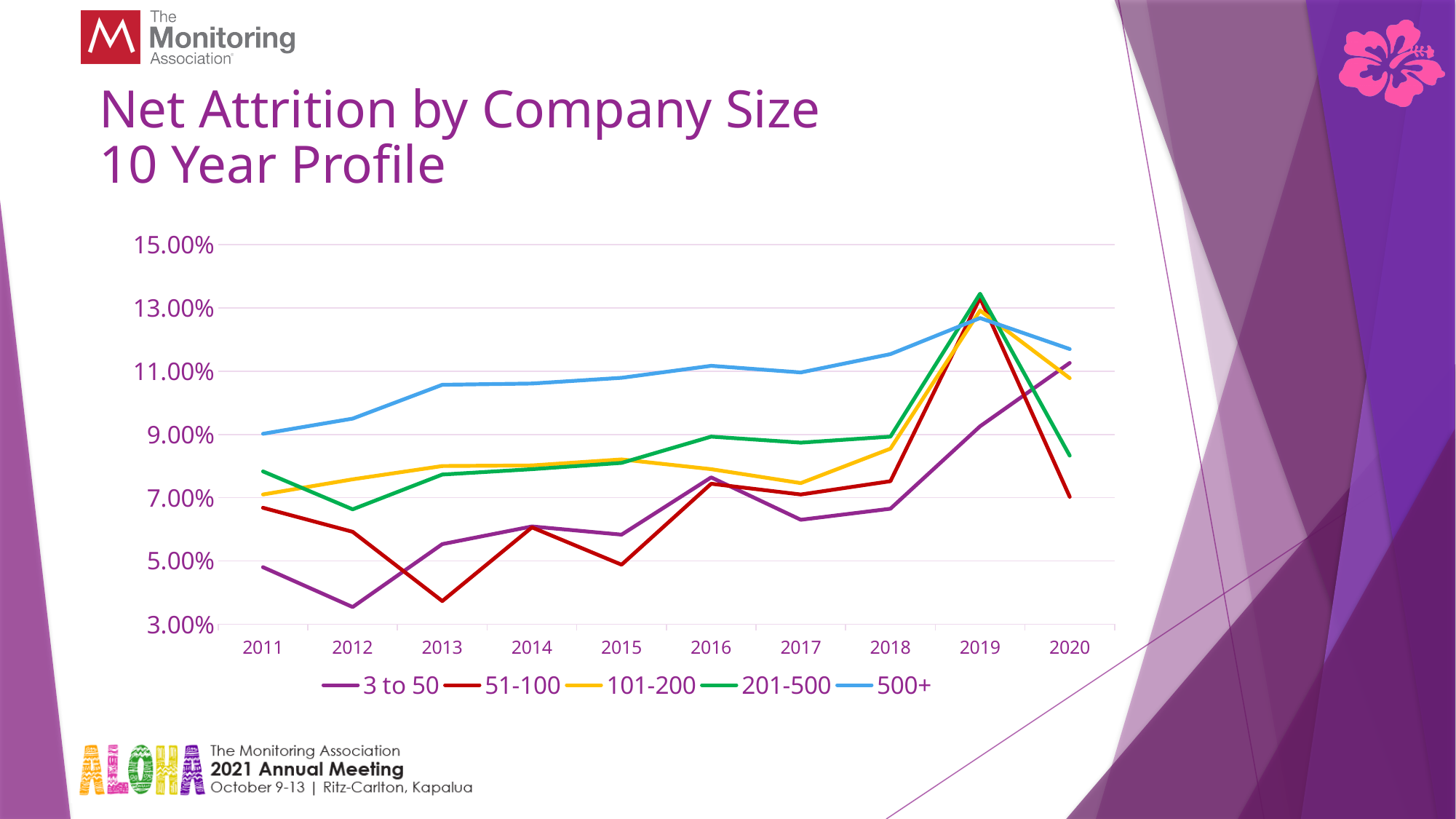
Is the value for the 500+ series in 2015 greater or less than 9.00%? greater Is the value for the 3 to 50 series in 2012 greater or less than 5.00%? less Is the value for the 500+ series in 2019 greater or less than 11.00%? greater What is the title of the chart? Net Attrition by Company Size 10 Year Profile What kind of chart is shown on the slide? Line chart How many series does the legend list? 5 Does the 500+ series rise or fall from 2011 to 2019? rise How many years are shown along the x axis? 10 Which series has the highest value in 2011? 500+ Which series has the lowest value in 2020? 51-100 In 2020, which is larger: the value for 3 to 50 or the value for 51-100? 3 to 50